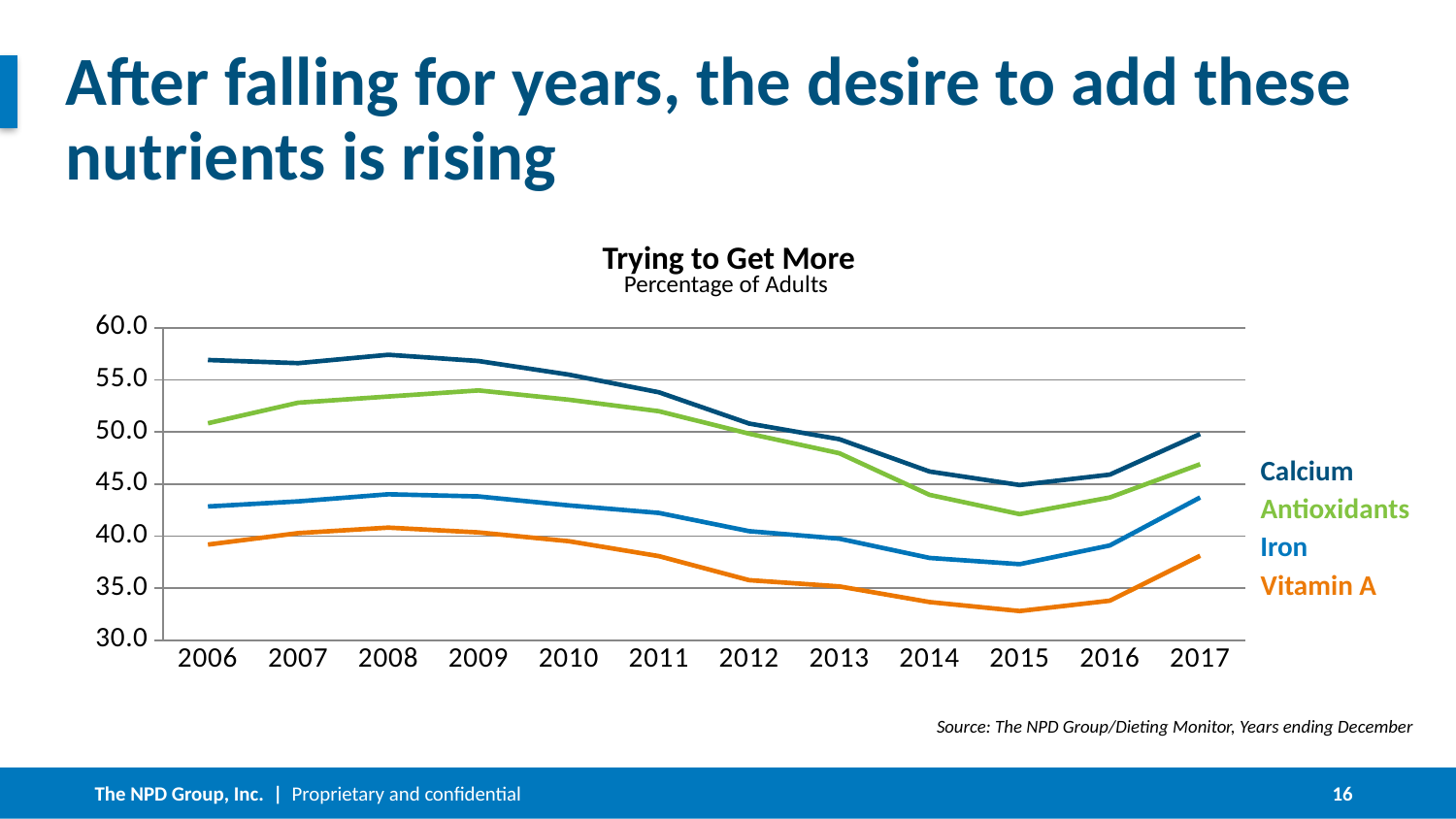
In which year does the Vitamin A line reach its lowest point? 2015 How many years are plotted along the x axis? 12 How many series does the chart show? 4 Which series has the highest values across the chart? Calcium Is the value for Vitamin A in 2015 greater or less than 35.0? less Is the value for Calcium in 2006 greater or less than 55.0? greater What is the title of the chart? Trying to Get More Is the value for Antioxidants in 2009 greater or less than 50.0? greater Which is larger in 2017, Antioxidants or Iron? Antioxidants Which series has the lowest values across the chart? Vitamin A What kind of chart is shown on the slide? line chart Does the Calcium line rise or fall from 2009 to 2015? fall